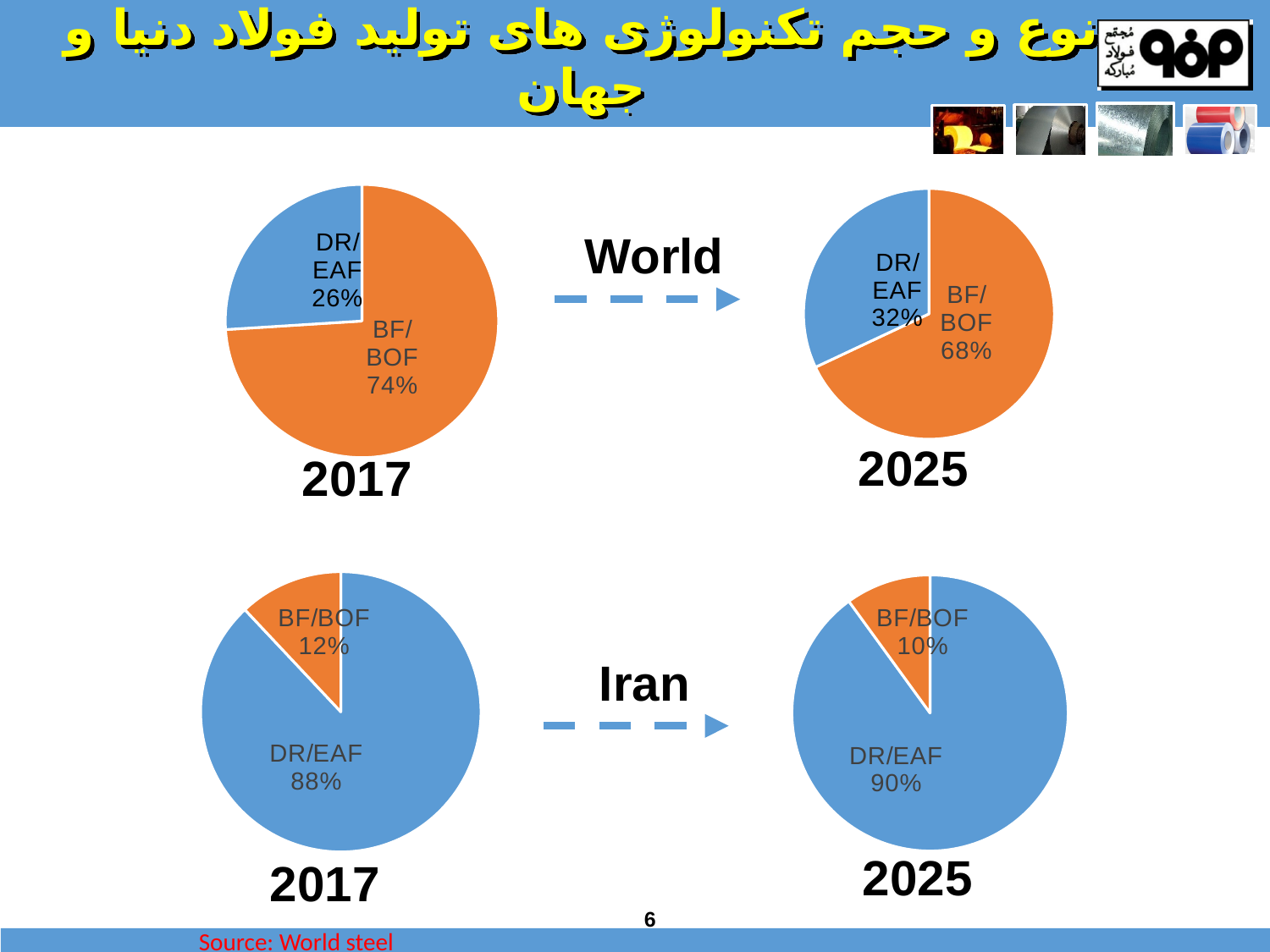
What type of chart is used for the World 2017 data? Pie chart In the World 2017 pie chart, which slice is the smallest? DR/EAF How many slices does the Iran 2017 pie chart have? 2 In the World 2025 pie chart, what share does BF/BOF have? 68% In the World 2025 pie chart, what share does DR/EAF have? 32% In the Iran 2017 pie chart, what share does DR/EAF have? 88% In the World 2017 pie chart, what share does DR/EAF have? 26% In the Iran 2025 pie chart, which slice is the largest? DR/EAF In the Iran 2017 pie chart, which is larger, BF/BOF or DR/EAF? DR/EAF In the World 2017 pie chart, what share does BF/BOF have? 74% In the World 2025 pie chart, what is the difference between the BF/BOF share and the DR/EAF share? 36% In the Iran 2025 pie chart, what share does BF/BOF have? 10%